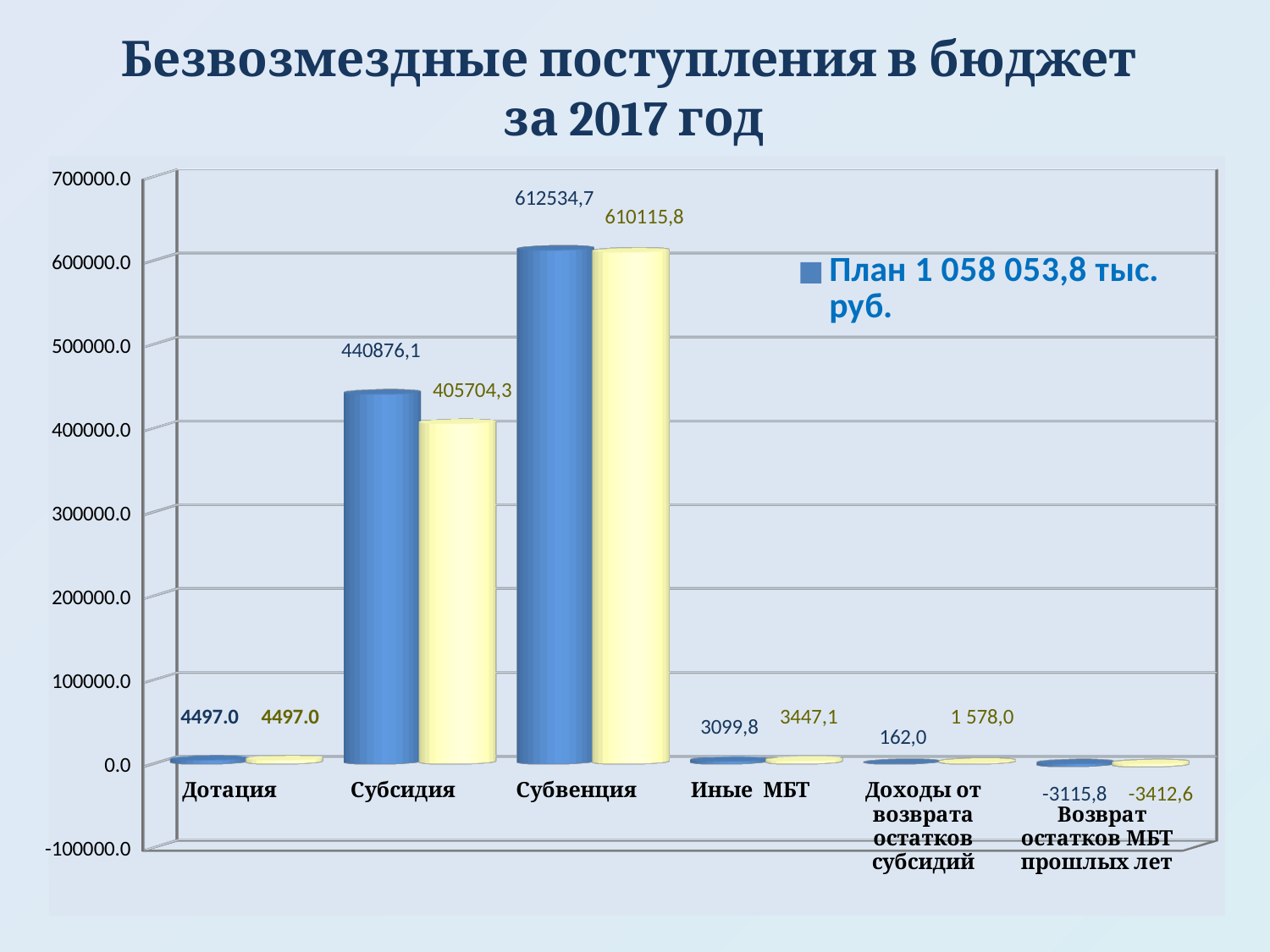
Which category has the highest values in the chart? Субвенция Is the blue (План) value for Субсидия greater or less than 400000? greater How many categories are shown on the x axis of the chart? 6 For Иные МБТ, which bar is larger, the blue one or the yellow one? the yellow one What is the difference between the blue and yellow bars for Субсидия? 35171,8 What is the value of the yellow bar for Доходы от возврата остатков субсидий? 1 578,0 What is the difference between the blue and yellow bars for Субвенция? 2418,9 Which category has the lowest values in the chart? Возврат остатков МБТ прошлых лет What is the value of the blue (План) bar for Возврат остатков МБТ прошлых лет? -3115,8 What is the value of the blue (План) bar for Субсидия? 440876,1 What type of chart is shown on the slide? bar chart What is the value of the yellow bar for Субвенция? 610115,8